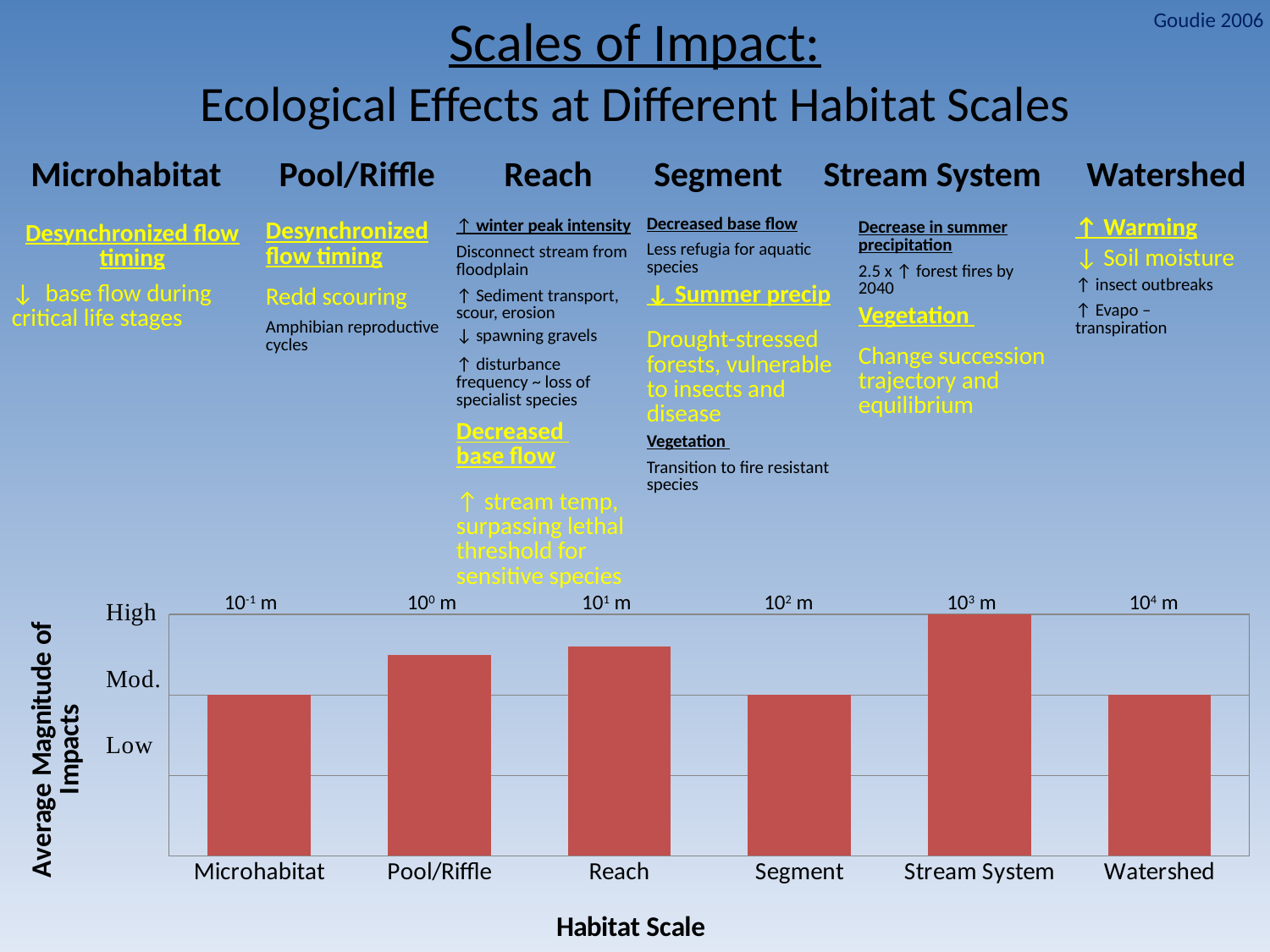
Is the bar for Reach above or below the 'Mod.' level on the y axis? above Is the bar for Stream System above or below the 'Mod.' level on the y axis? above How many habitat scale categories are plotted on the x axis of the chart? 6 Do the bar heights rise steadily from Microhabitat to Watershed along the x axis? No What is the title of the y axis of the chart? Average Magnitude of Impacts Which bar is taller in the chart, Stream System or Microhabitat? Stream System Which bar is taller in the chart, Pool/Riffle or Watershed? Pool/Riffle What kind of chart is shown at the bottom of the slide? bar chart What is the title of the x axis of the chart? Habitat Scale Which bar is taller in the chart, Reach or Segment? Reach Which habitat scale has the highest average magnitude of impacts in the chart? Stream System